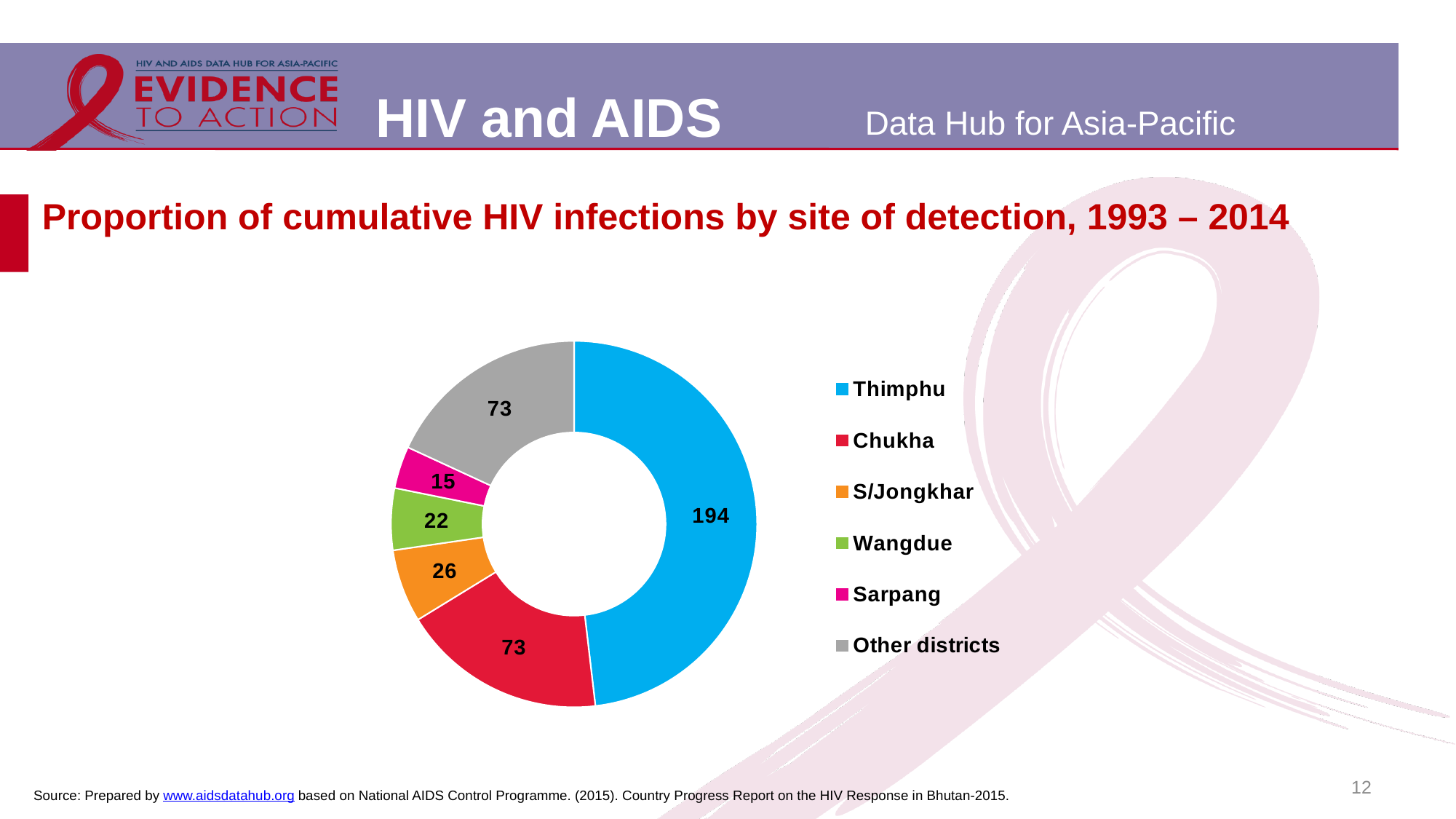
Which is larger, the value for S/Jongkhar or the value for Wangdue? S/Jongkhar What is the value for Thimphu? 194 How many categories does the chart show? 6 What is the total of all the values shown in the chart? 403 What is the difference between the values for Thimphu and Chukha? 121 What is the value for S/Jongkhar? 26 Which site of detection has the highest number of cumulative HIV infections? Thimphu What is the value for Sarpang? 15 Which site of detection has the lowest number of cumulative HIV infections? Sarpang What is the value for Wangdue? 22 What is the title of the chart? Proportion of cumulative HIV infections by site of detection, 1993 – 2014 What kind of chart is shown on the slide? Pie chart (doughnut)